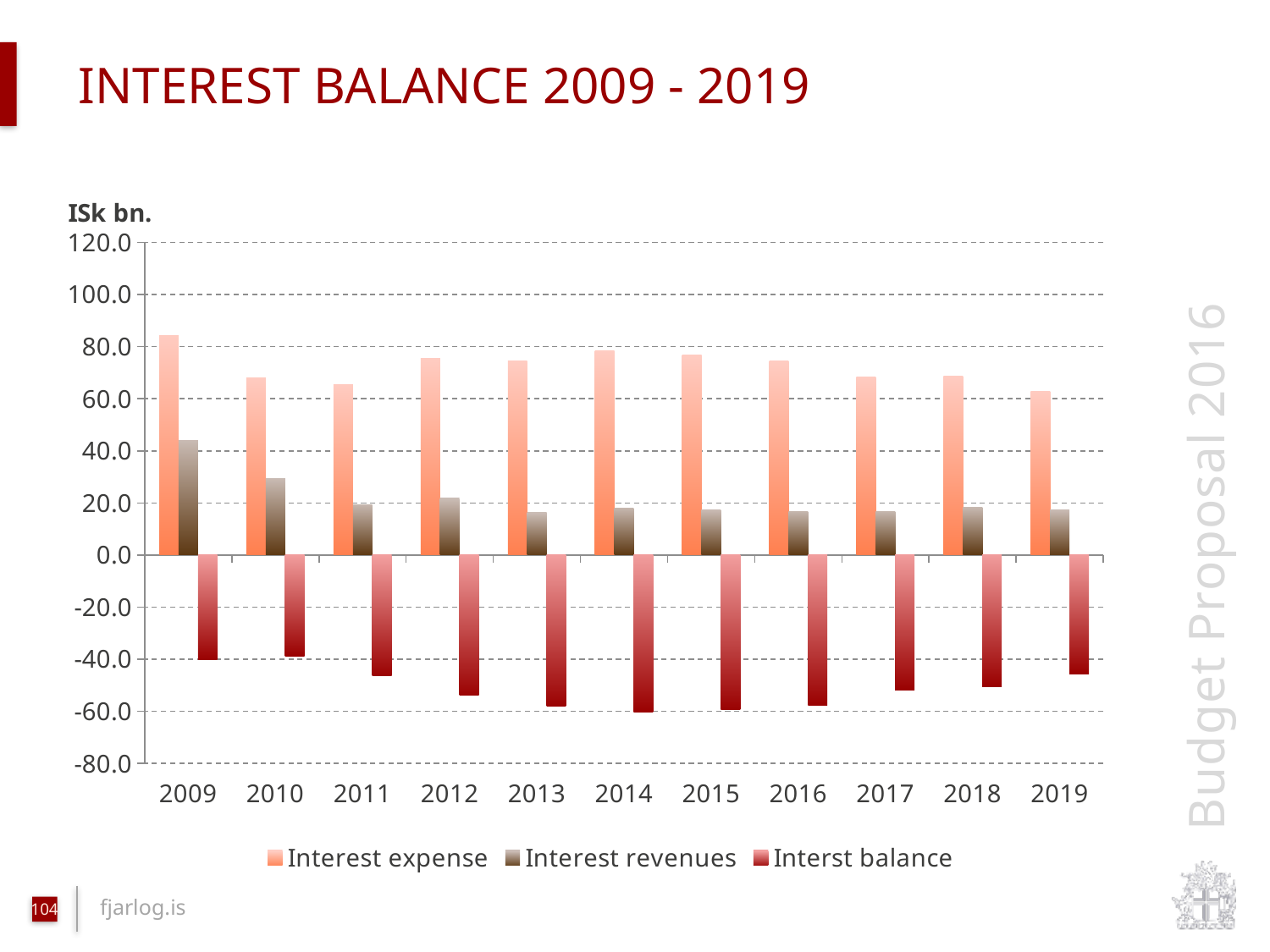
Which year has the highest Interest revenues? 2009 Which is larger, the Interest expense in 2009 or in 2010? 2009 Is the Interest revenues value for 2009 greater or less than 40.0? greater What kind of chart is shown on the slide? bar chart Is the Interest revenues value for 2010 greater or less than 20.0? greater How many years are shown on the x axis? 11 Which year has the highest Interest expense? 2009 Is the Interest expense for 2009 greater or less than 80.0? greater How many series does the legend list? 3 Do the Interest revenues rise or fall from 2009 to 2011? fall What unit label is shown above the vertical axis? ISk bn.